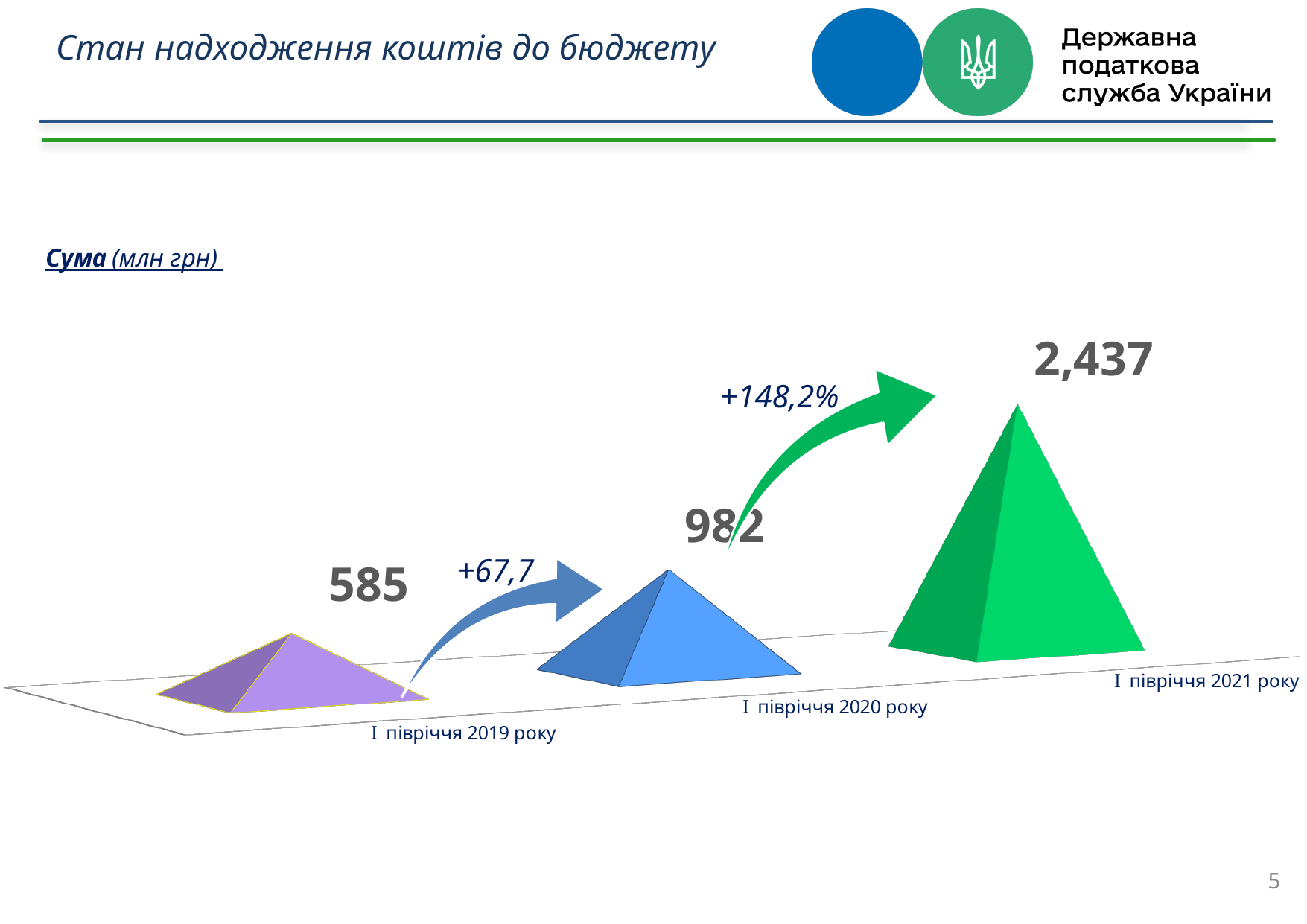
Which period has the lowest value? I півріччя 2019 року What unit is stated for the values in the chart? млн грн What is the value for I півріччя 2021 року? 2,437 Do the values rise or fall from I півріччя 2019 року to I півріччя 2021 року? rise What is the value for I півріччя 2020 року? 982 What is the difference between the values for I півріччя 2021 року and I півріччя 2020 року? 1,455 How many periods are shown in the chart? 3 Which period has the highest value? I півріччя 2021 року What is the difference between the values for I півріччя 2020 року and I півріччя 2019 року? 397 What is the value for I півріччя 2019 року? 585 Which is larger, the value for I півріччя 2020 року or I півріччя 2019 року? I півріччя 2020 року What percentage change is shown on the arrow between I півріччя 2020 року and I півріччя 2021 року? +148,2%